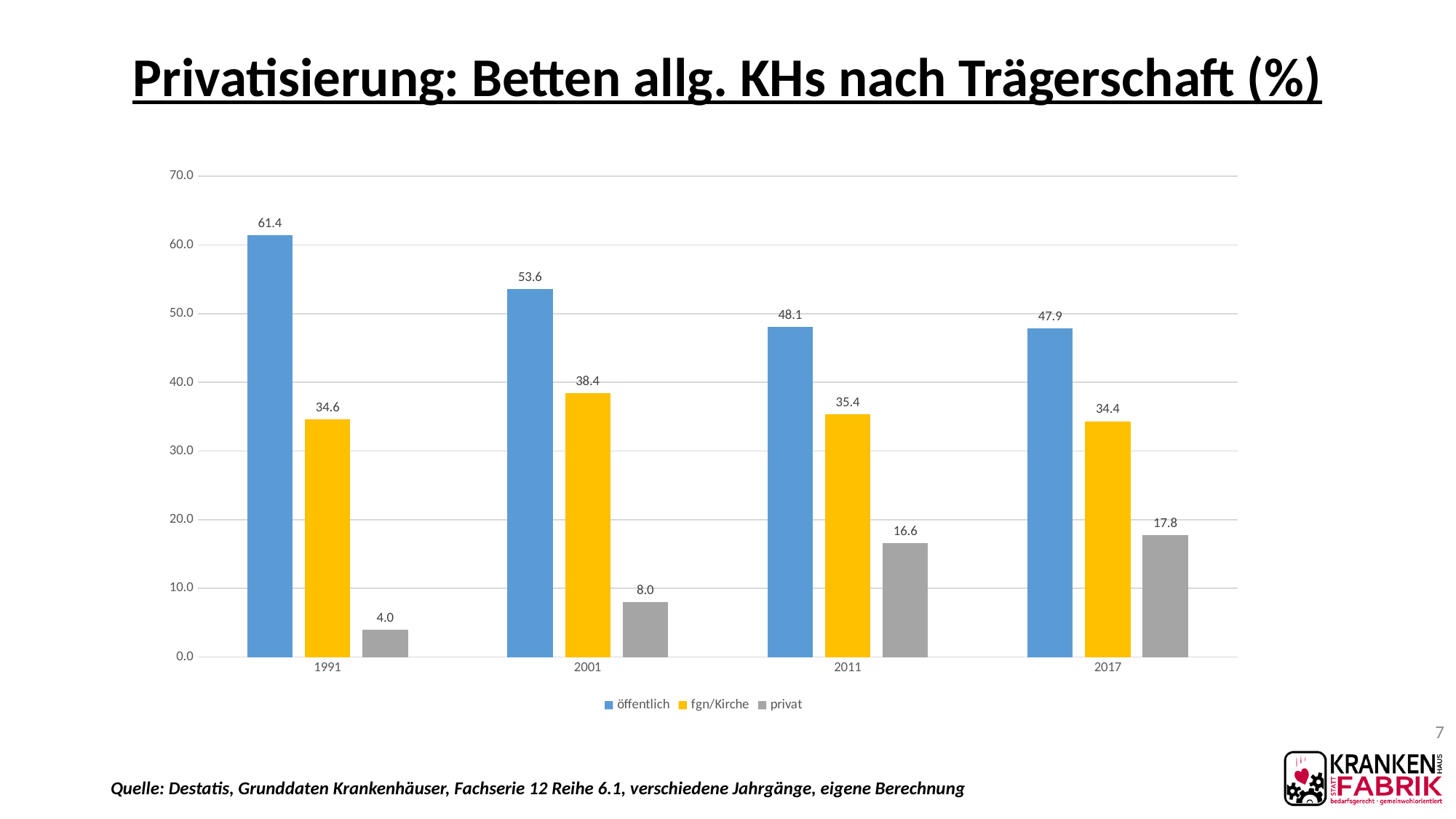
In which year is the privat series highest? 2017 How many years are shown on the x axis? 4 Does the privat series rise or fall from 1991 to 2017? rise What kind of chart is shown on the slide? bar chart What is the difference between the öffentlich values for 1991 and 2017? 13.5 How many series does the legend list? 3 In which year is the öffentlich series lowest? 2017 What is the value for öffentlich in 1991? 61.4 What is the value for privat in 2011? 16.6 Is the value for öffentlich in 2001 greater or less than 50.0? greater Which is larger, the fgn/Kirche value in 2011 or the privat value in 2011? fgn/Kirche What is the value for fgn/Kirche in 2001? 38.4